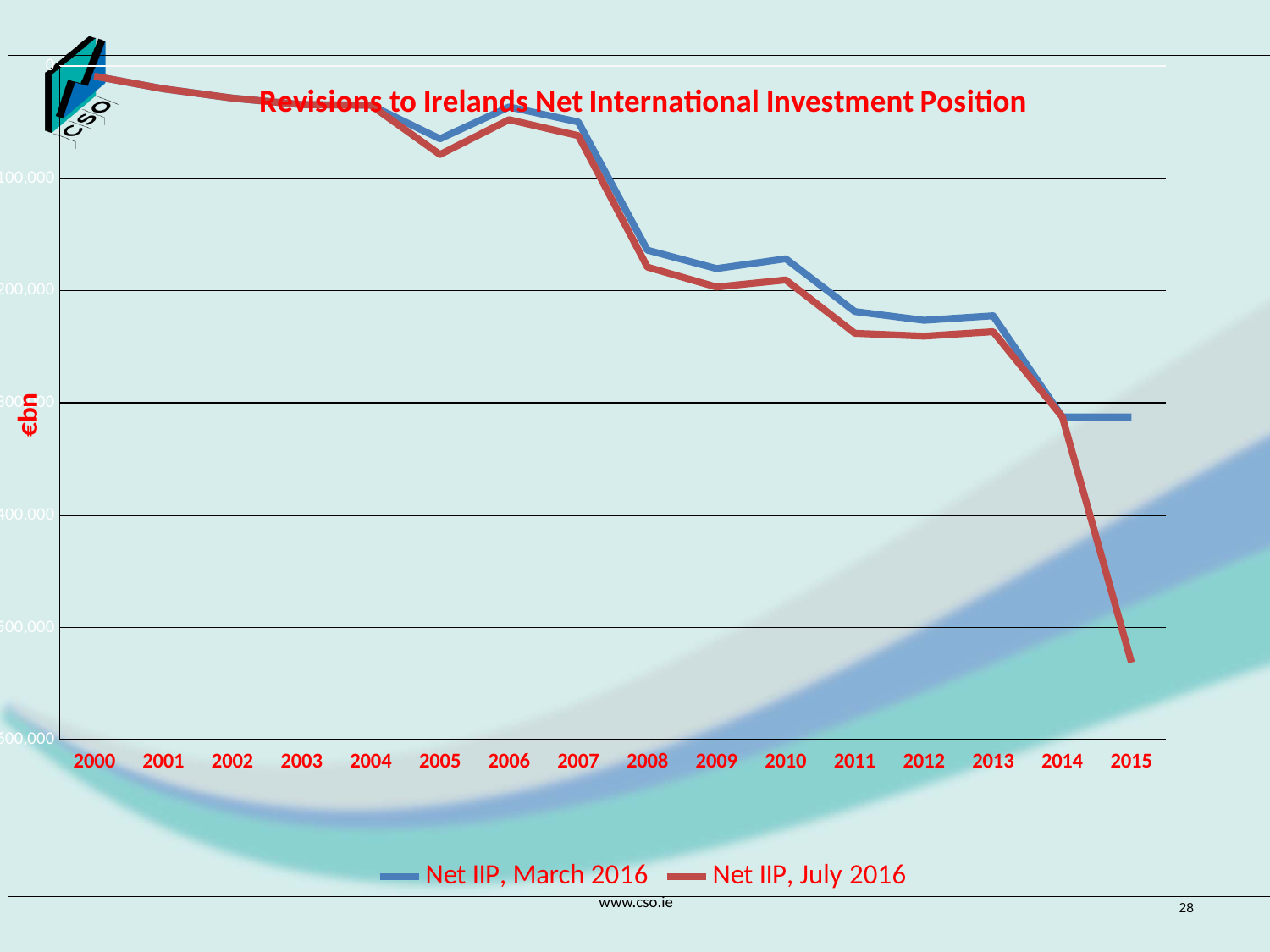
In which year is the Net IIP, March 2016 series at its highest? 2000 In which year is the Net IIP, July 2016 series at its highest? 2000 In which year is the Net IIP, July 2016 series at its lowest? 2015 In 2015, which series has the higher value: Net IIP, March 2016 or Net IIP, July 2016? Net IIP, March 2016 What is the title of the chart? Revisions to Irelands Net International Investment Position How many years are shown along the x axis? 16 What are the two series named in the legend? Net IIP, March 2016 and Net IIP, July 2016 In 2005, which series has the higher value: Net IIP, March 2016 or Net IIP, July 2016? Net IIP, March 2016 How many series does the legend list? 2 What kind of chart is shown on the slide? Line chart Do the values of the Net IIP, July 2016 series generally rise or fall from 2000 to 2015? Fall Between 2014 and 2015, does the Net IIP, July 2016 series rise or fall? Fall